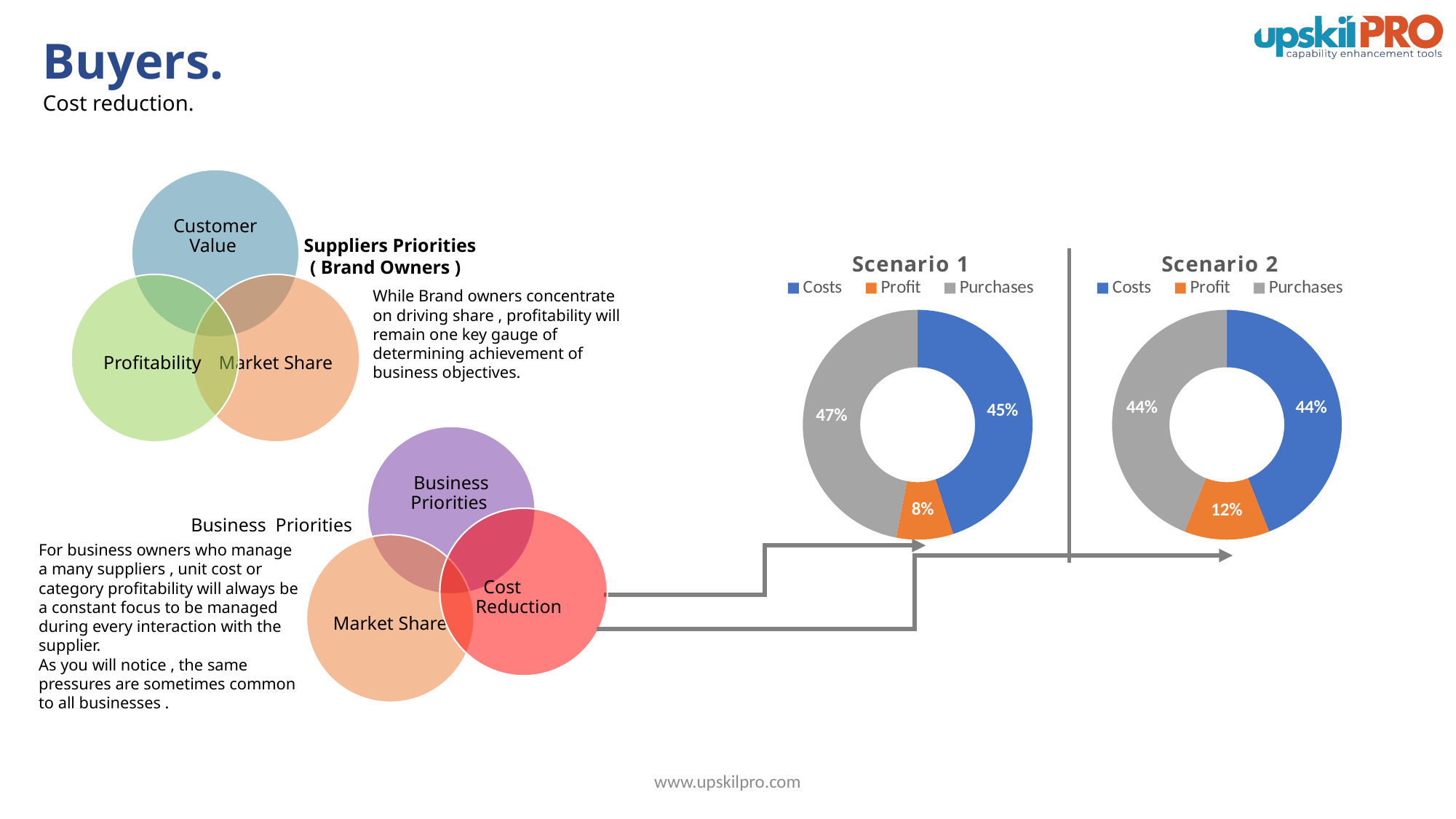
In the Scenario 2 chart, what is the value for Profit? 12% In the Scenario 1 chart, what is the value for Purchases? 47% What is the difference between the Profit values in the Scenario 2 chart and the Scenario 1 chart? 4% In the Scenario 2 chart, what is the value for Costs? 44% In the Scenario 1 chart, which category has the smallest share? Profit In the Scenario 1 chart, what is the value for Profit? 8% In the Scenario 1 chart, which category has the largest share? Purchases In the Scenario 1 chart, which is larger, Costs or Purchases? Purchases How many series does the legend of the Scenario 2 chart list? 3 In the Scenario 2 chart, which category has the smallest share? Profit In the Scenario 1 chart, what is the value for Costs? 45% What type of chart is the Scenario 1 chart? Doughnut chart